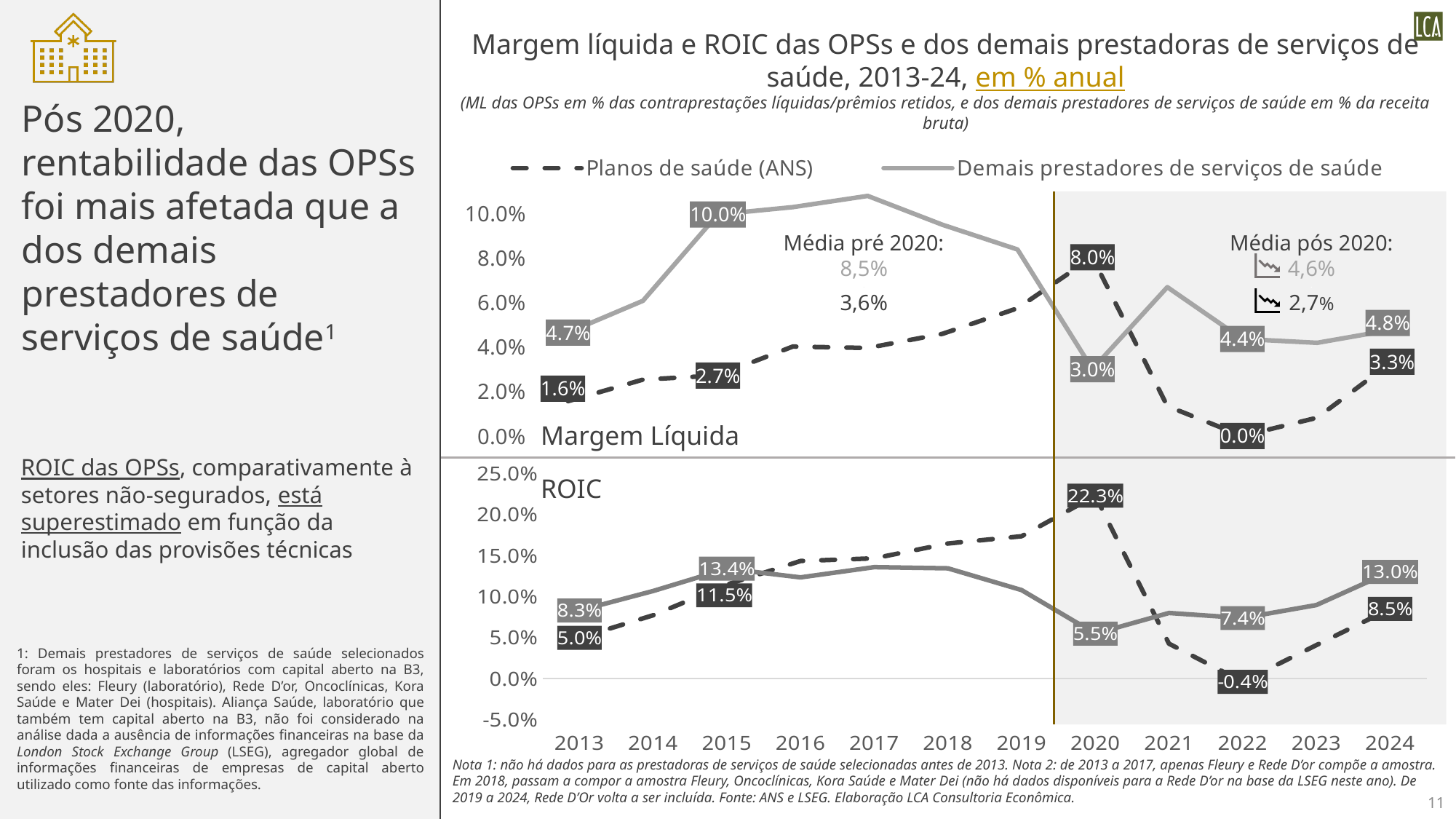
In the Margem Líquida chart, what is the value for Demais prestadores de serviços de saúde in 2015? 10.0% In the Margem Líquida chart, which series has the higher value in 2024, Planos de saúde (ANS) or Demais prestadores de serviços de saúde? Demais prestadores de serviços de saúde In the ROIC chart, what is the value for Planos de saúde (ANS) in 2022? -0.4% In the Margem Líquida chart, is the value for Demais prestadores de serviços de saúde in 2017 greater or less than 10.0%? greater How many years are shown on the x axis of the charts? 12 In the Margem Líquida chart, what is the value for Planos de saúde (ANS) in 2020? 8.0% What kind of chart is the ROIC chart? line chart In the Margem Líquida chart, what is the 'Média pré 2020' value shown for Planos de saúde (ANS)? 3,6% In the ROIC chart, what is the value for Demais prestadores de serviços de saúde in 2024? 13.0% In the ROIC chart, what is the difference between Planos de saúde (ANS) and Demais prestadores de serviços de saúde in 2020? 16.8% How many series does the legend list? 2 In the ROIC chart, is the value for Planos de saúde (ANS) in 2019 greater or less than 15.0%? greater